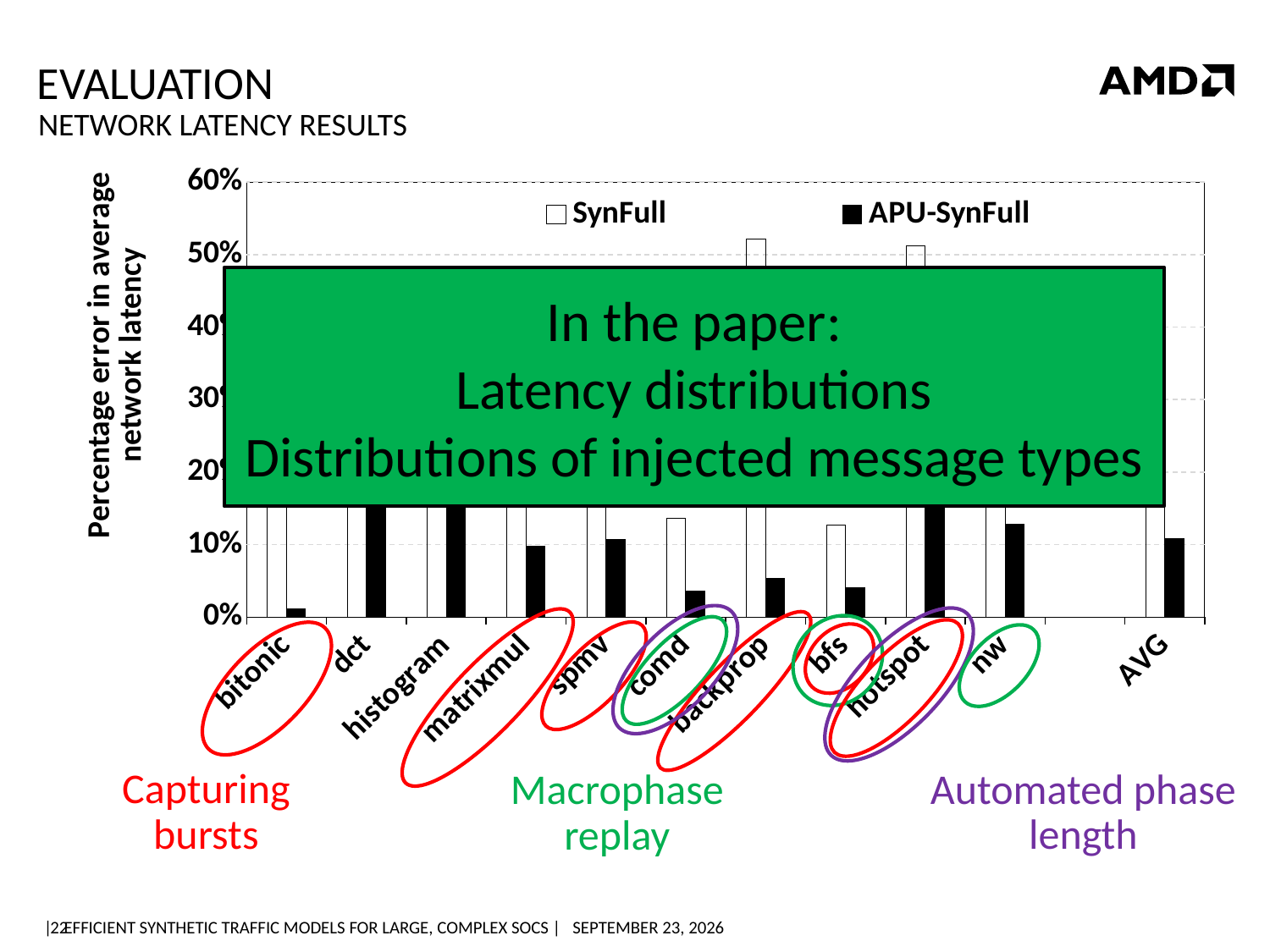
What kind of chart is shown on the slide? bar chart What are the two series named in the chart legend? SynFull and APU-SynFull How many categories are shown along the x axis of the chart? 11 Is the SynFull value for hotspot greater or less than 40%? greater Is the APU-SynFull value for bitonic greater or less than 10%? less What is the label of the y axis of the chart? Percentage error in average network latency For comd, which series has the larger value, SynFull or APU-SynFull? SynFull Among the visible APU-SynFull bars, which category has the lowest value? bitonic Is the SynFull value for backprop greater or less than 40%? greater Which has the larger APU-SynFull value, bitonic or nw? nw How many series does the chart legend list? 2